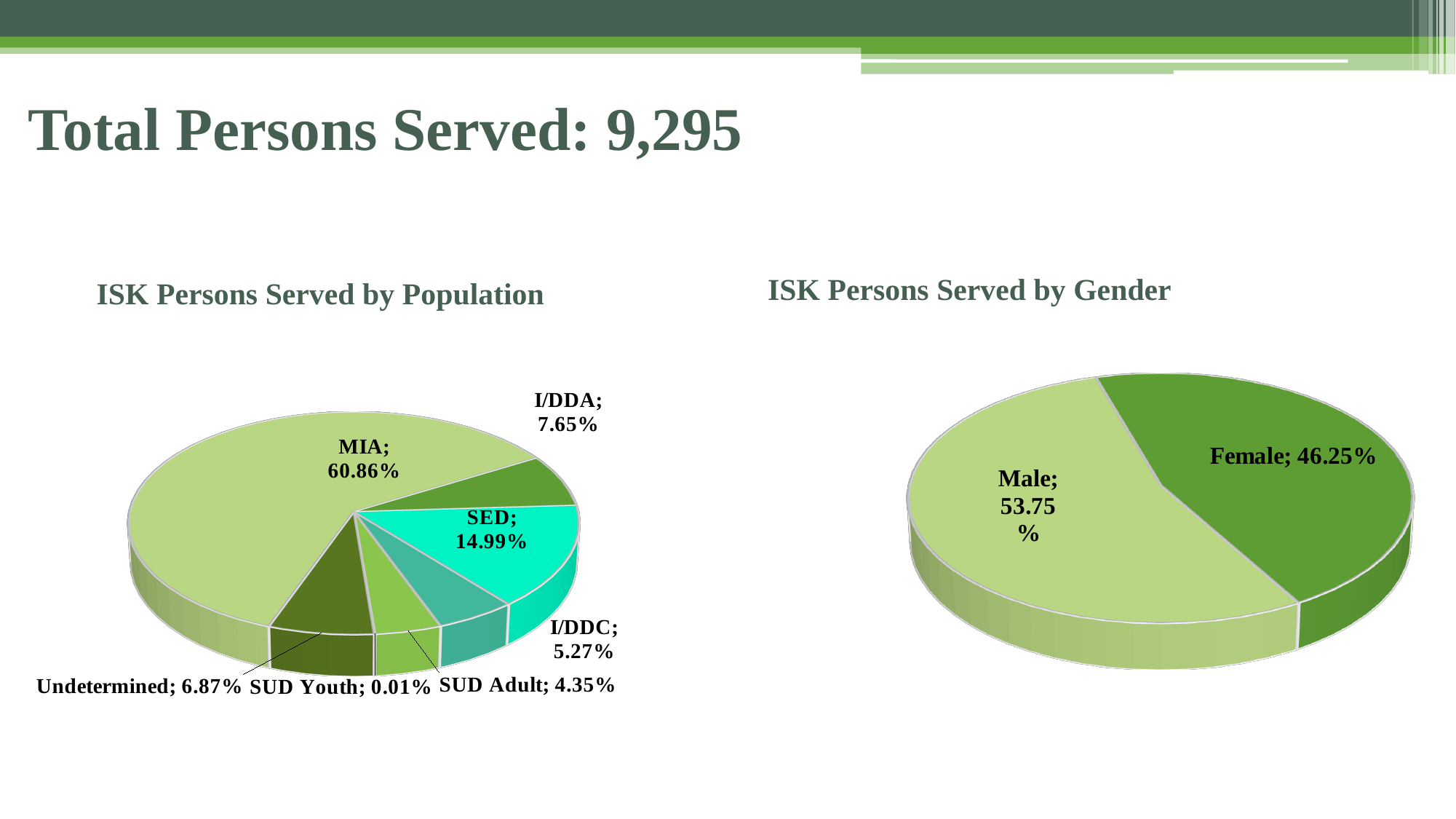
What kind of chart is the 'ISK Persons Served by Gender' chart? Pie chart In the 'ISK Persons Served by Population' chart, which category has the largest share? MIA In the 'ISK Persons Served by Gender' chart, what share is Female? 46.25% In the 'ISK Persons Served by Population' chart, which is larger, Undetermined or I/DDC? Undetermined In the 'ISK Persons Served by Population' chart, what share does I/DDA have? 7.65% In the 'ISK Persons Served by Population' chart, what share does SED have? 14.99% In the 'ISK Persons Served by Population' chart, what is the difference between the SED and I/DDA shares? 7.34% In the 'ISK Persons Served by Gender' chart, what share is Male? 53.75% In the 'ISK Persons Served by Population' chart, which category has the smallest share? SUD Youth In the 'ISK Persons Served by Population' chart, what share does MIA have? 60.86% In the 'ISK Persons Served by Gender' chart, what is the difference between the Male and Female shares? 7.50% In the 'ISK Persons Served by Population' chart, how many categories are shown? 7